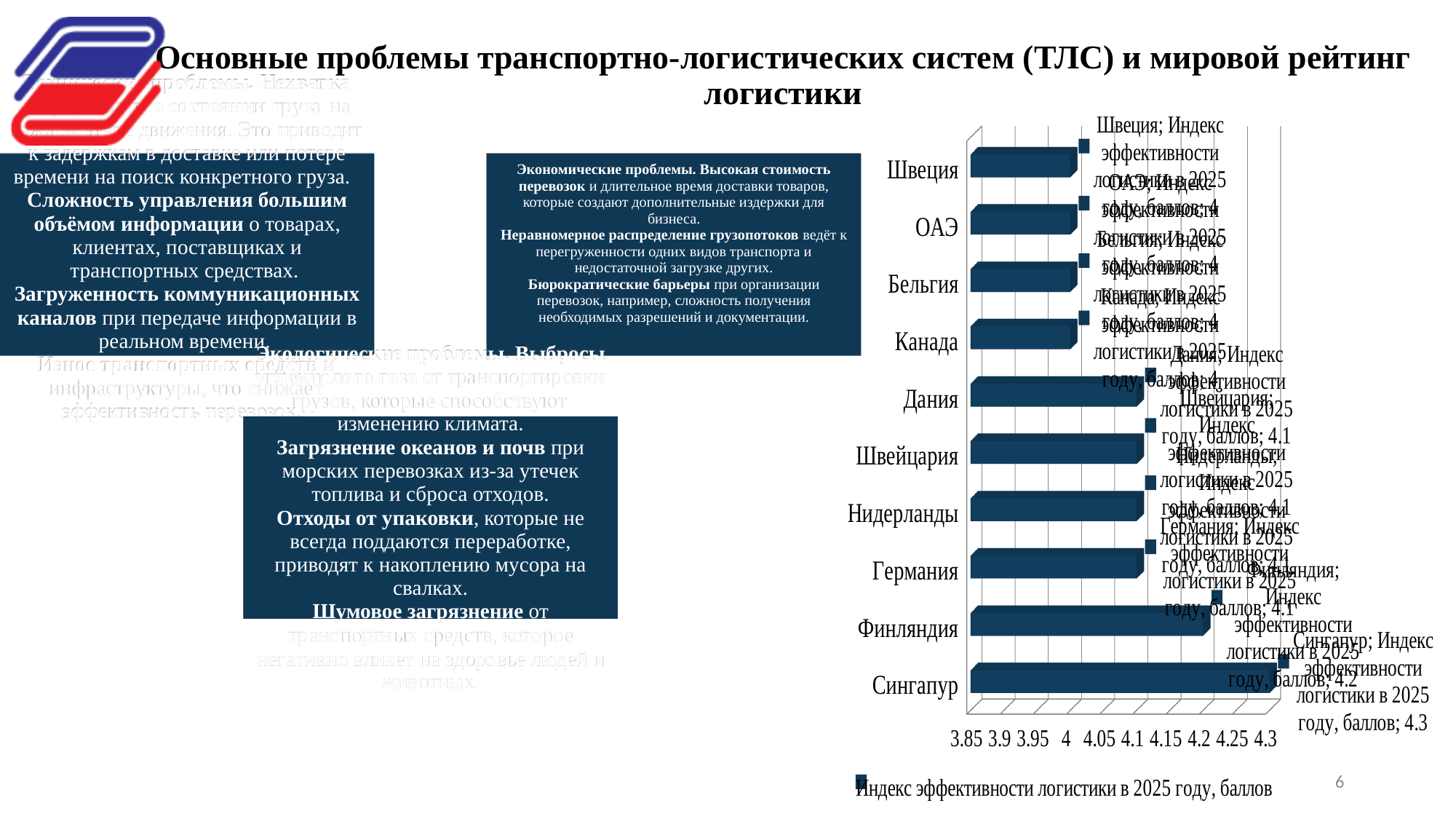
Is the value for Сингапур greater or less than 4.2? greater What is the difference between the values for Сингапур and Финляндия? 0.1 Which is larger, the value for Сингапур or the value for Швеция? Сингапур What is the legend entry of the chart? Индекс эффективности логистики в 2025 году, баллов How many series does the legend list? 1 What kind of chart is shown on the slide? bar chart Which country has the highest value? Сингапур What is the value for Финляндия? 4.2 What is the value for Швеция? 4 How many countries are shown in the chart? 10 What is the value for Сингапур? 4.3 What is the value for Дания? 4.1